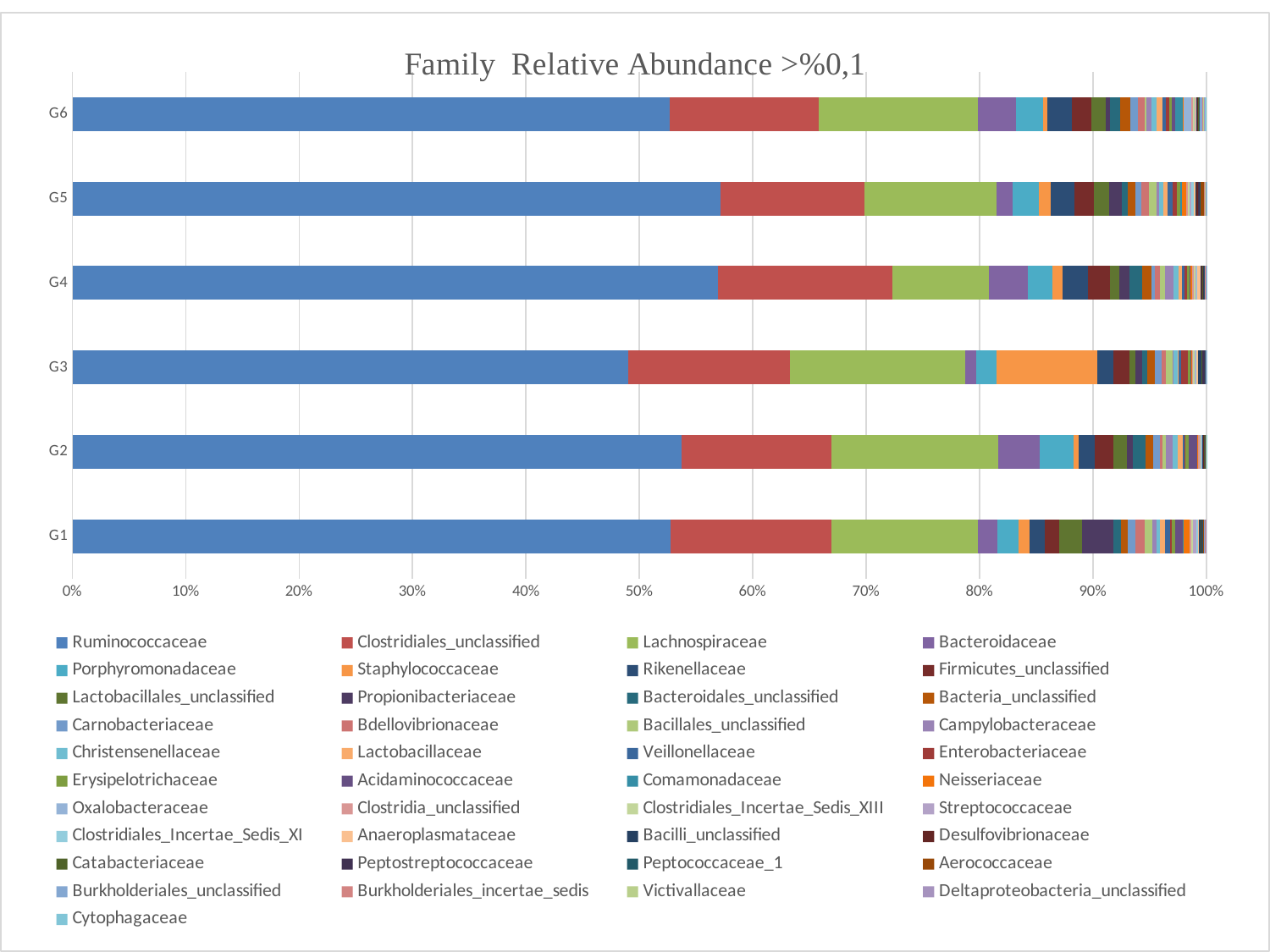
Is the value for Ruminococcaceae in G6 greater or less than 50%? greater What kind of chart is shown on the slide? Stacked bar chart What is the title of the chart? Family Relative Abundance >%0,1 Which is larger, the Ruminococcaceae share in G3 or in G5? G5 Is the value for Ruminococcaceae in G5 greater or less than 50%? greater Which group has the smallest Ruminococcaceae share? G3 Is the value for Ruminococcaceae in G4 greater or less than 60%? less How many series does the legend list? 41 How many groups (categories) are plotted on the vertical axis? 6 Which group has the largest Staphylococcaceae share? G3 Which series is listed first in the legend? Ruminococcaceae